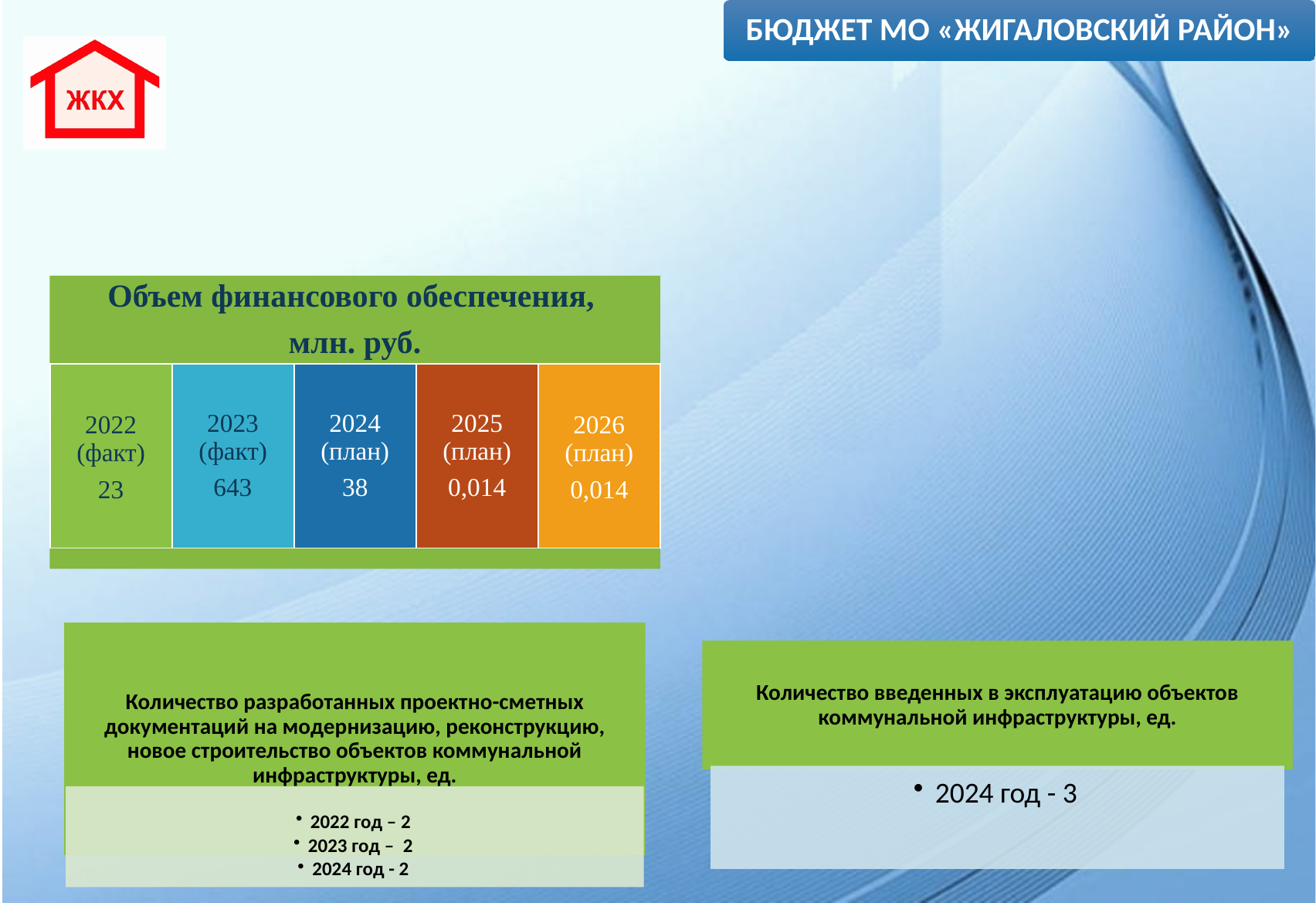
In the chart "Объем финансового обеспечения, млн. руб.", what is the value for 2022 (факт)? 23 In the chart "Объем финансового обеспечения, млн. руб.", what is the difference between the values for 2024 (план) and 2022 (факт)? 15 In the chart "Объем финансового обеспечения, млн. руб.", do the values rise or fall from 2024 (план) to 2025 (план)? fall In the chart "Объем финансового обеспечения, млн. руб.", what is the value for 2025 (план)? 0,014 In the chart "Объем финансового обеспечения, млн. руб.", what is the value for 2024 (план)? 38 In the chart "Объем финансового обеспечения, млн. руб.", which year has the highest value? 2023 (факт) In the chart "Объем финансового обеспечения, млн. руб.", what is the value for 2026 (план)? 0,014 In the chart "Объем финансового обеспечения, млн. руб.", what is the difference between the values for 2023 (факт) and 2024 (план)? 605 How many years are shown in the chart "Объем финансового обеспечения, млн. руб."? 5 In the chart "Объем финансового обеспечения, млн. руб.", what is the value for 2023 (факт)? 643 In the chart "Объем финансового обеспечения, млн. руб.", which is larger, the value for 2022 (факт) or 2024 (план)? 2024 (план) What is the title of the chart on the left side of the slide? Объем финансового обеспечения, млн. руб.